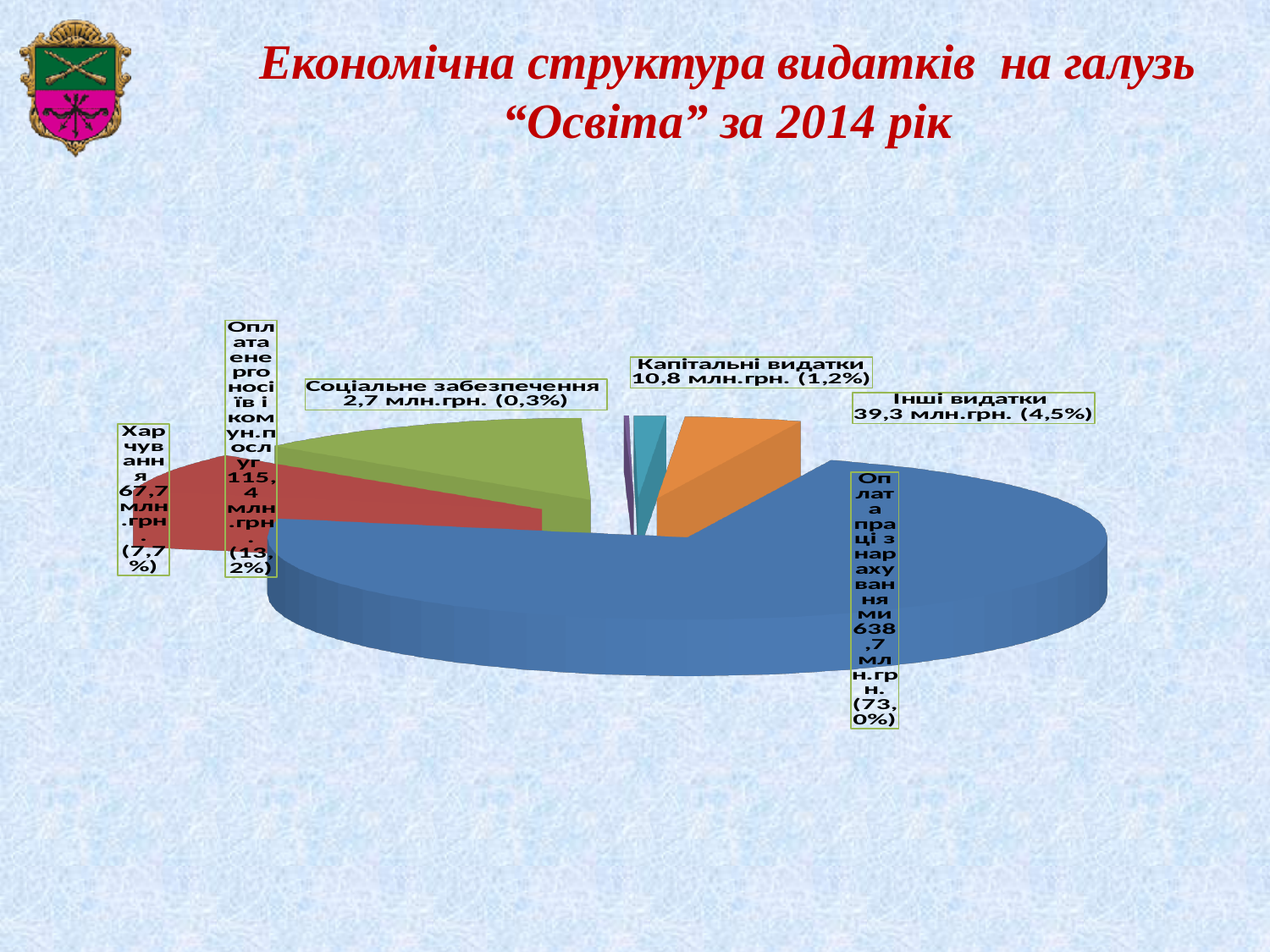
Which is larger, Харчування or Інші видатки? Харчування What is the value shown for Інші видатки? 39,3 млн.грн. Which category has the smallest slice of the pie? Соціальне забезпечення What share of the pie does Капітальні видатки represent? 1,2% How many slices does the pie chart have? 6 What share of the pie does Оплата праці з нарахуваннями represent? 73,0% What is the title of the chart on the slide? Економічна структура видатків на галузь “Освіта” за 2014 рік Which category has the largest slice of the pie? Оплата праці з нарахуваннями What is the difference in percentage share between Оплата енергоносіїв і комун.послуг and Харчування? 5,5% What is the value shown for Соціальне забезпечення? 2,7 млн.грн. What is the value shown for Оплата праці з нарахуваннями? 638,7 млн.грн. What kind of chart is shown on the slide? pie chart